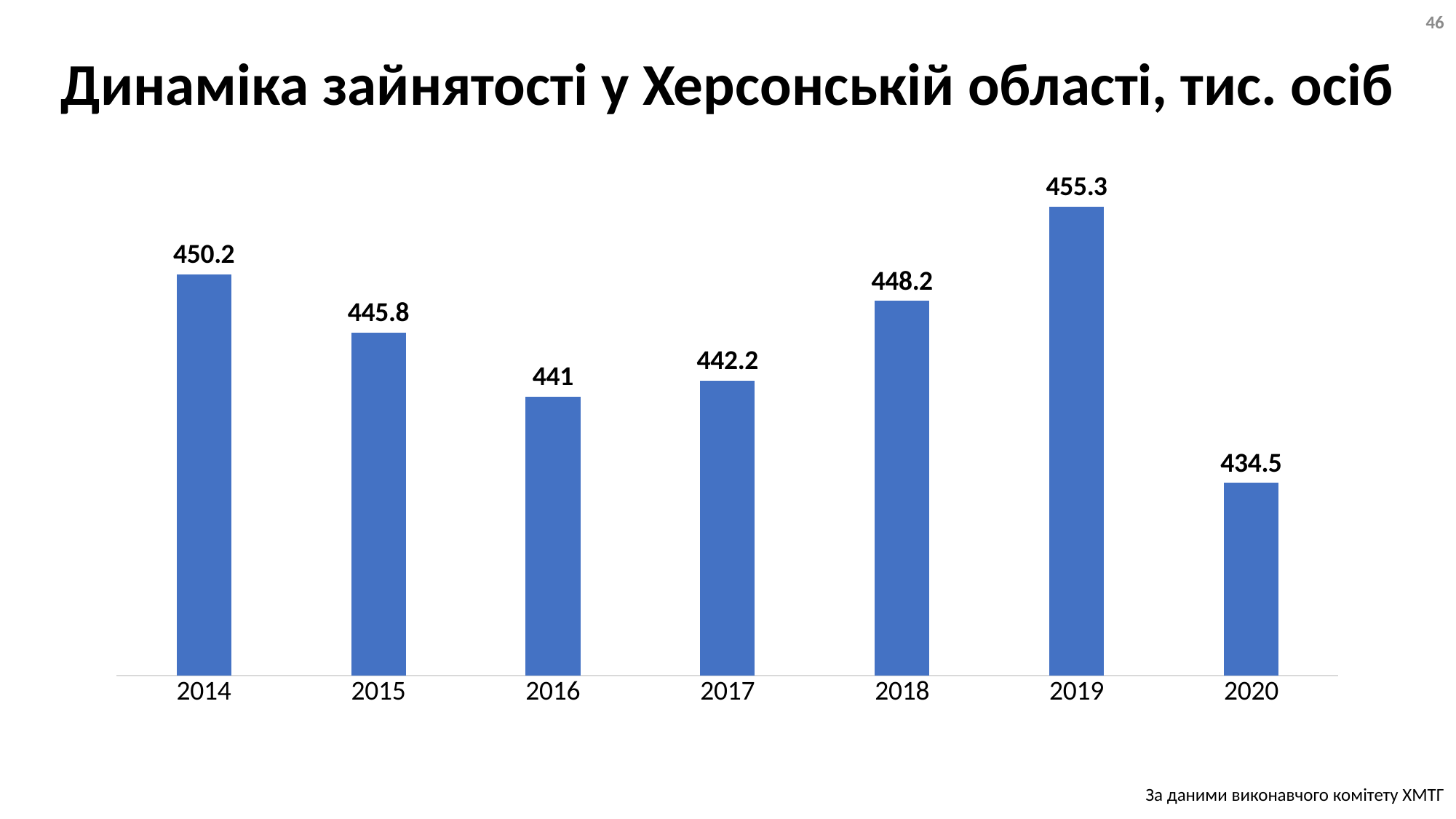
What is the employment value for 2014? 450.2 Which year has the highest employment value? 2019 What is the difference between the values for 2014 and 2015? 4.4 What is the employment value for 2020? 434.5 What kind of chart is shown on the slide? bar chart What is the employment value for 2016? 441 Which is larger, the value for 2017 or the value for 2018? 2018 What is the difference between the values for 2019 and 2020? 20.8 What is the title of the chart? Динаміка зайнятості у Херсонській області, тис. осіб Which year has the lowest employment value? 2020 Do the values rise or fall from 2016 to 2019? rise How many years are shown on the x axis? 7